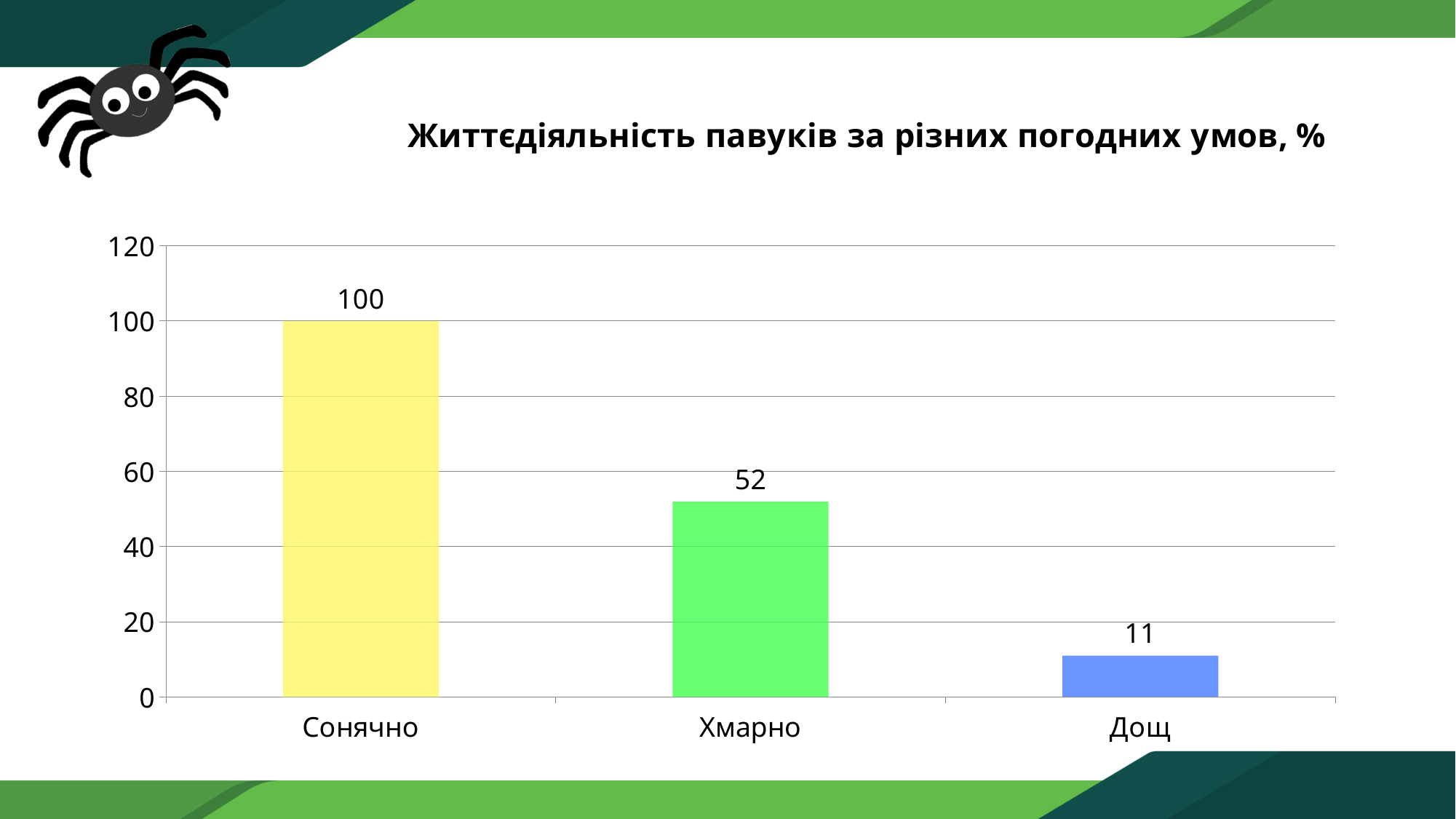
How many categories are shown on the x axis? 3 What is the value for Хмарно? 52 What is the value for Дощ? 11 Is the value for Хмарно greater or less than 60? less Which is larger, the value for Хмарно or the value for Дощ? Хмарно What is the difference between the values for Сонячно and Хмарно? 48 What is the difference between the values for Хмарно and Дощ? 41 What is the title of the chart? Життєдіяльність павуків за різних погодних умов, % What is the value for Сонячно? 100 What kind of chart is shown on the slide? bar chart Which category has the lowest value? Дощ Which category has the highest value? Сонячно